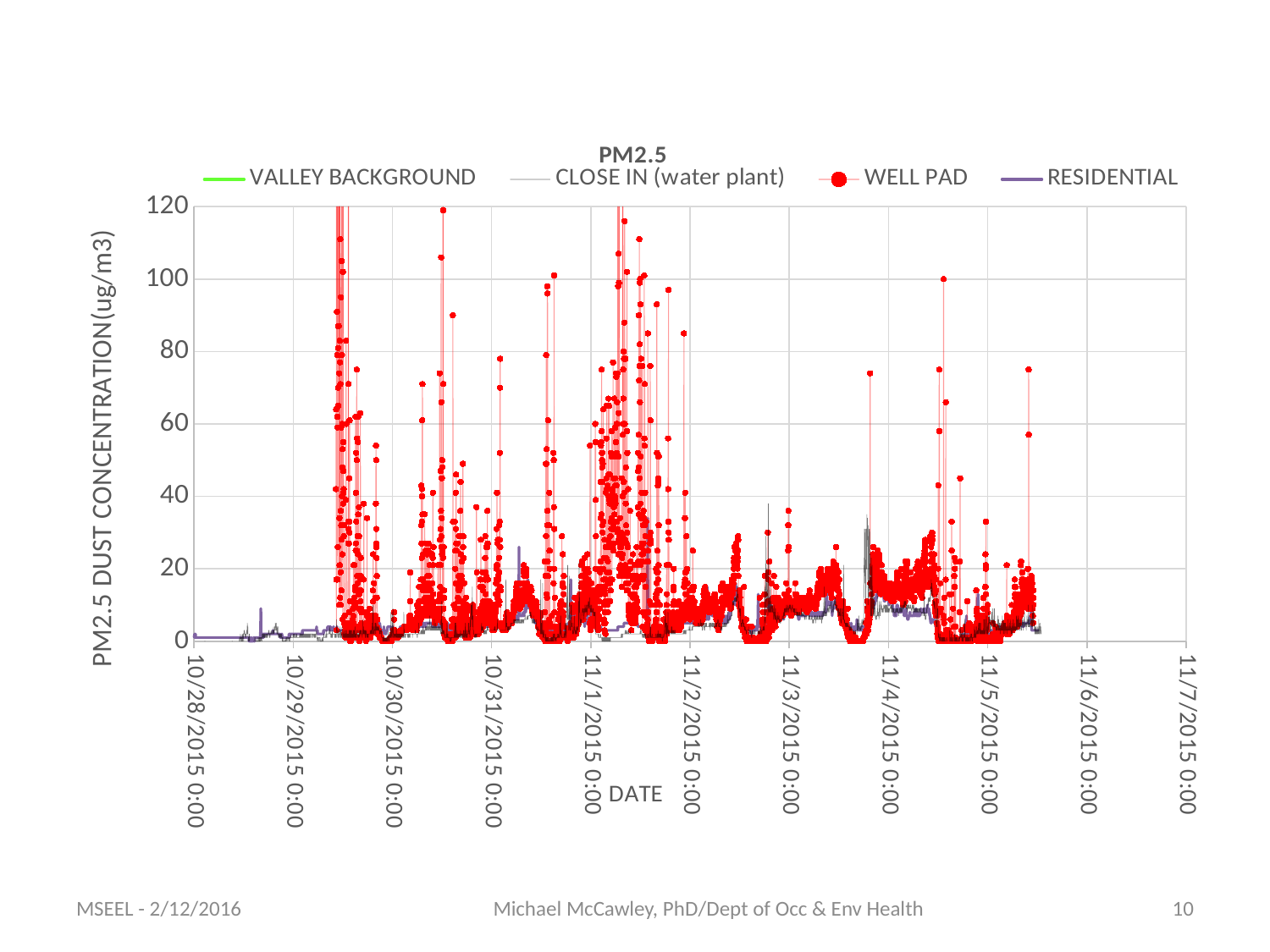
Is the highest value reached by the WELL PAD series greater or less than 100? greater What is the highest value shown on the y axis? 120 How many date tick labels are shown on the x axis? 11 What is the first date shown on the x axis? 10/28/2015 0:00 What is the label of the y axis? PM2.5 DUST CONCENTRATION(ug/m3) What kind of chart is shown on the slide? line chart Is the highest value reached by the RESIDENTIAL series greater or less than 40? less Does the WELL PAD series reach higher peaks before 11/2/2015 or after 11/2/2015? before 11/2/2015 What is the title of the chart? PM2.5 Which series reaches the highest peak values on the chart? WELL PAD Which series is plotted with red markers? WELL PAD How many series does the legend list? 4